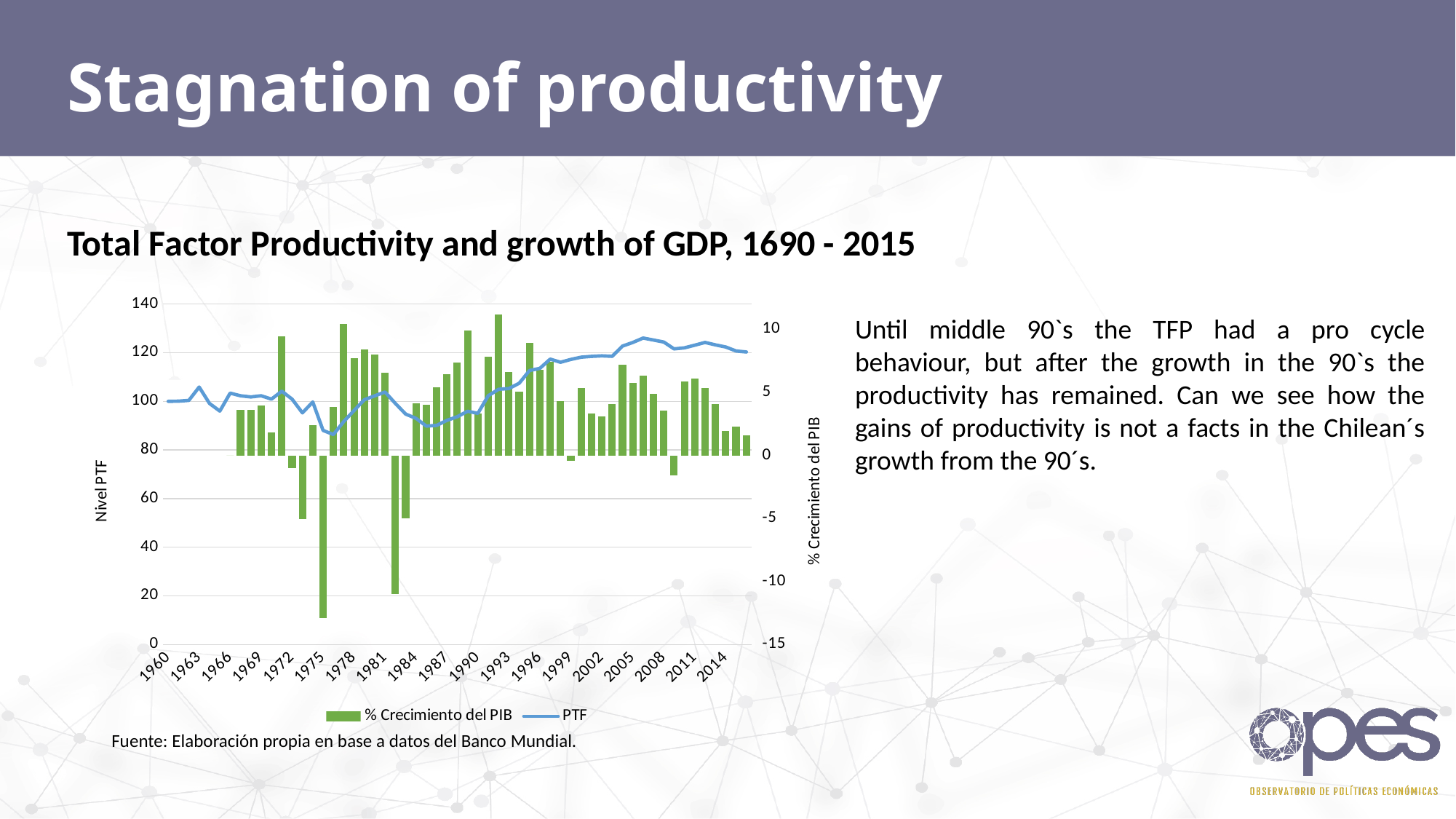
What kind of chart is shown on the slide? A combined bar and line chart How many year labels are shown on the x axis of the chart? 19 In which year does the % Crecimiento del PIB series reach its lowest value? 1975 Which series is drawn as bars in the chart? % Crecimiento del PIB How many series does the chart legend list? 2 Is the % Crecimiento del PIB value for 1975 greater or less than -10? less Which is larger, the PTF value in 1984 or the PTF value in 2005? 2005 What is the title of the right-hand vertical axis of the chart? % Crecimiento del PIB Is the PTF value for 2014 greater or less than 100? greater Is the PTF value for 1975 greater or less than 100? less